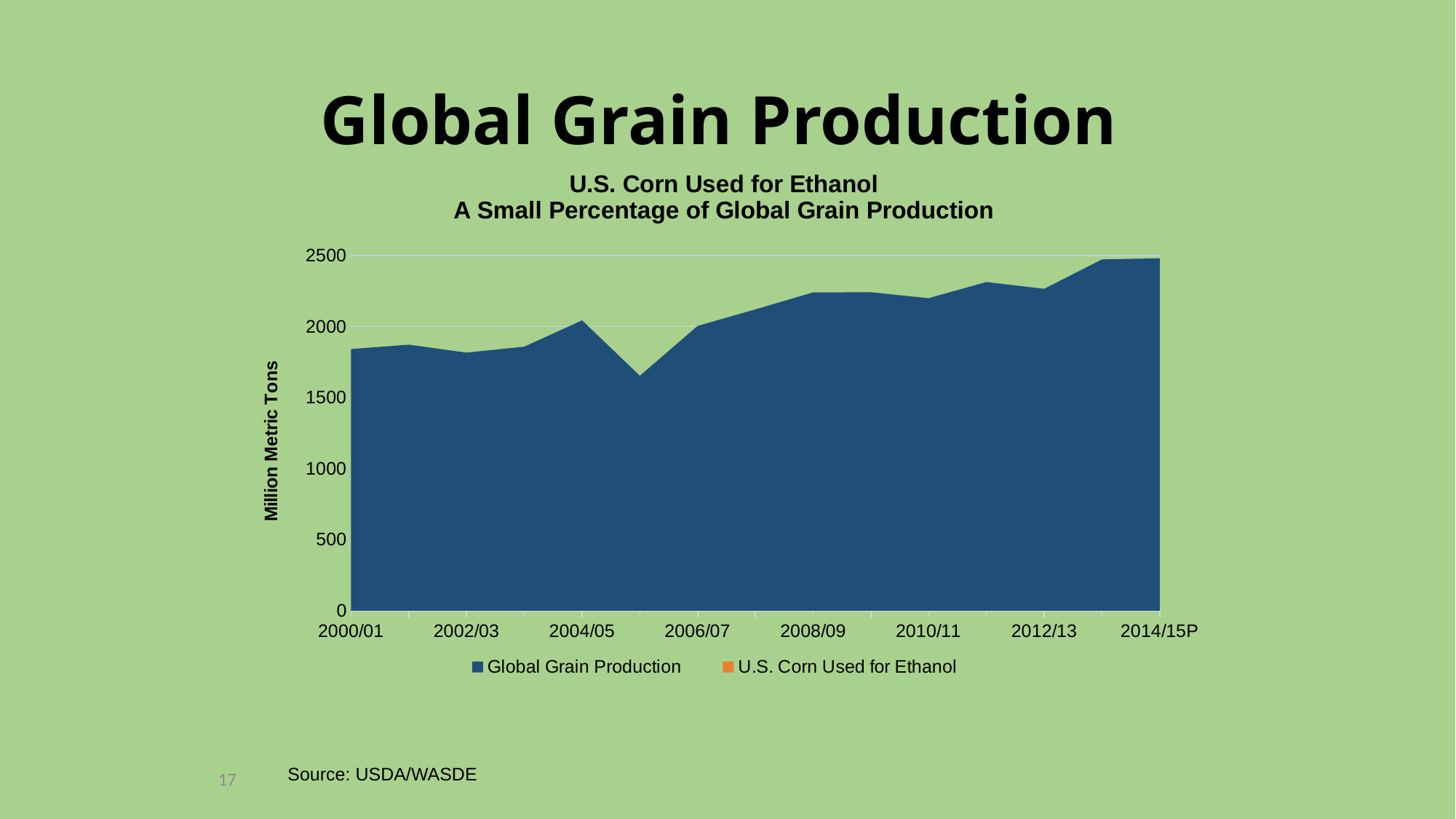
Is the Global Grain Production value for 2005/06 greater or less than 2000? less What is the source cited for the chart? USDA/WASDE Is the Global Grain Production value for 2000/01 greater or less than 2000? less Is the Global Grain Production value for 2008/09 greater or less than 2000? greater Which year has the highest Global Grain Production? 2014/15P Which is larger, Global Grain Production in 2008/09 or in 2000/01? 2008/09 Which year has the lowest Global Grain Production? 2005/06 How many series does the legend list? 2 Overall, does Global Grain Production rise or fall from 2000/01 to 2014/15P? rise What kind of chart is shown on the slide? Area chart What is the label on the vertical axis of the chart? Million Metric Tons